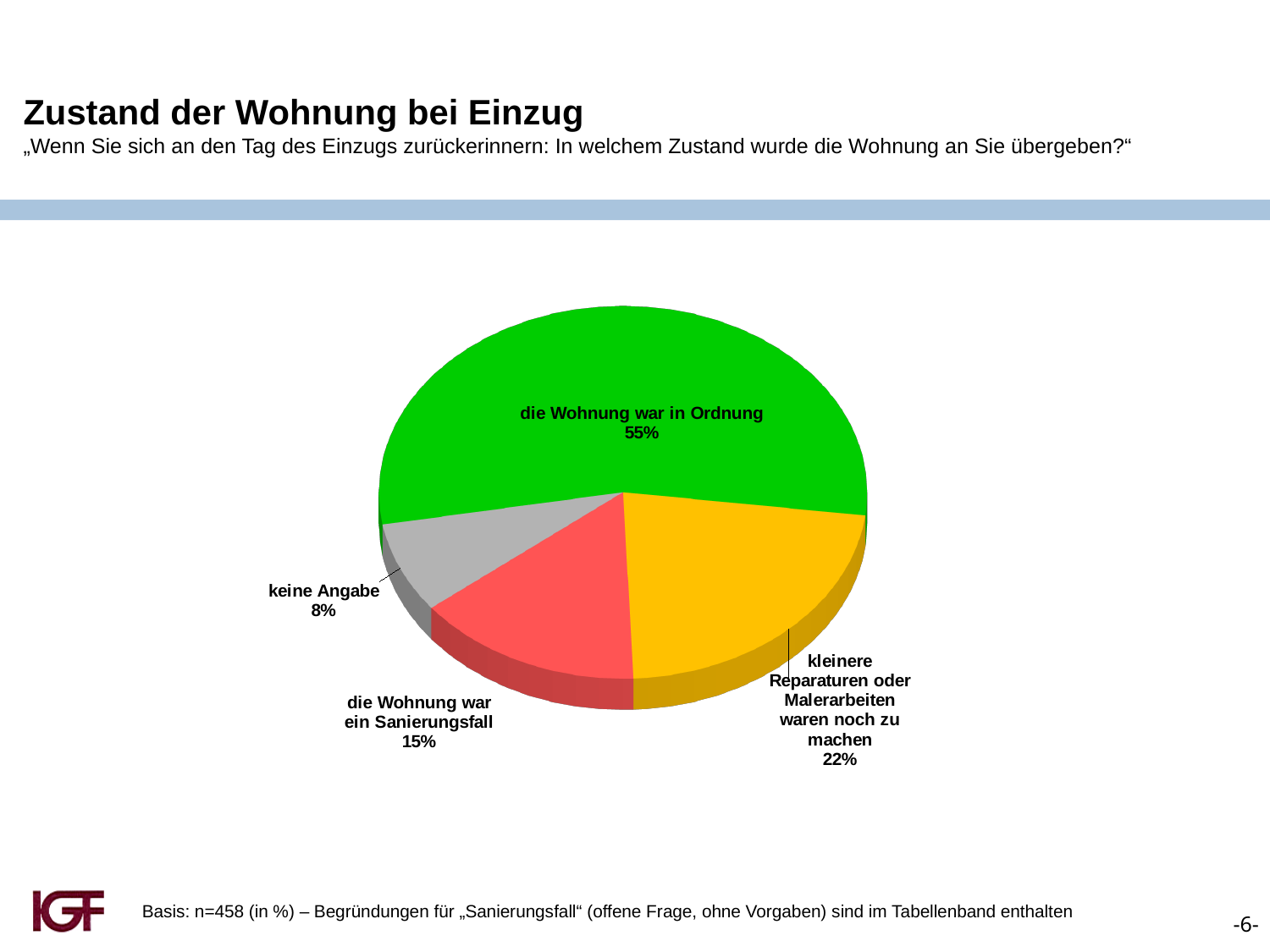
What percentage of respondents said "die Wohnung war in Ordnung"? 55% How many categories are shown in the pie chart? 4 What is the difference in percentage points between "die Wohnung war in Ordnung" and "kleinere Reparaturen oder Malerarbeiten waren noch zu machen"? 33 percentage points What percentage is given for "kleinere Reparaturen oder Malerarbeiten waren noch zu machen"? 22% Which category has the smallest slice of the pie? keine Angabe What colour is the slice for "die Wohnung war in Ordnung"? Green Which is larger: the share for "die Wohnung war ein Sanierungsfall" or for "keine Angabe"? die Wohnung war ein Sanierungsfall What percentage of respondents gave "keine Angabe"? 8% What type of chart is shown on the slide? Pie chart What is the title of the slide containing the chart? Zustand der Wohnung bei Einzug Which category has the largest slice of the pie? die Wohnung war in Ordnung What share is shown for "die Wohnung war ein Sanierungsfall"? 15%